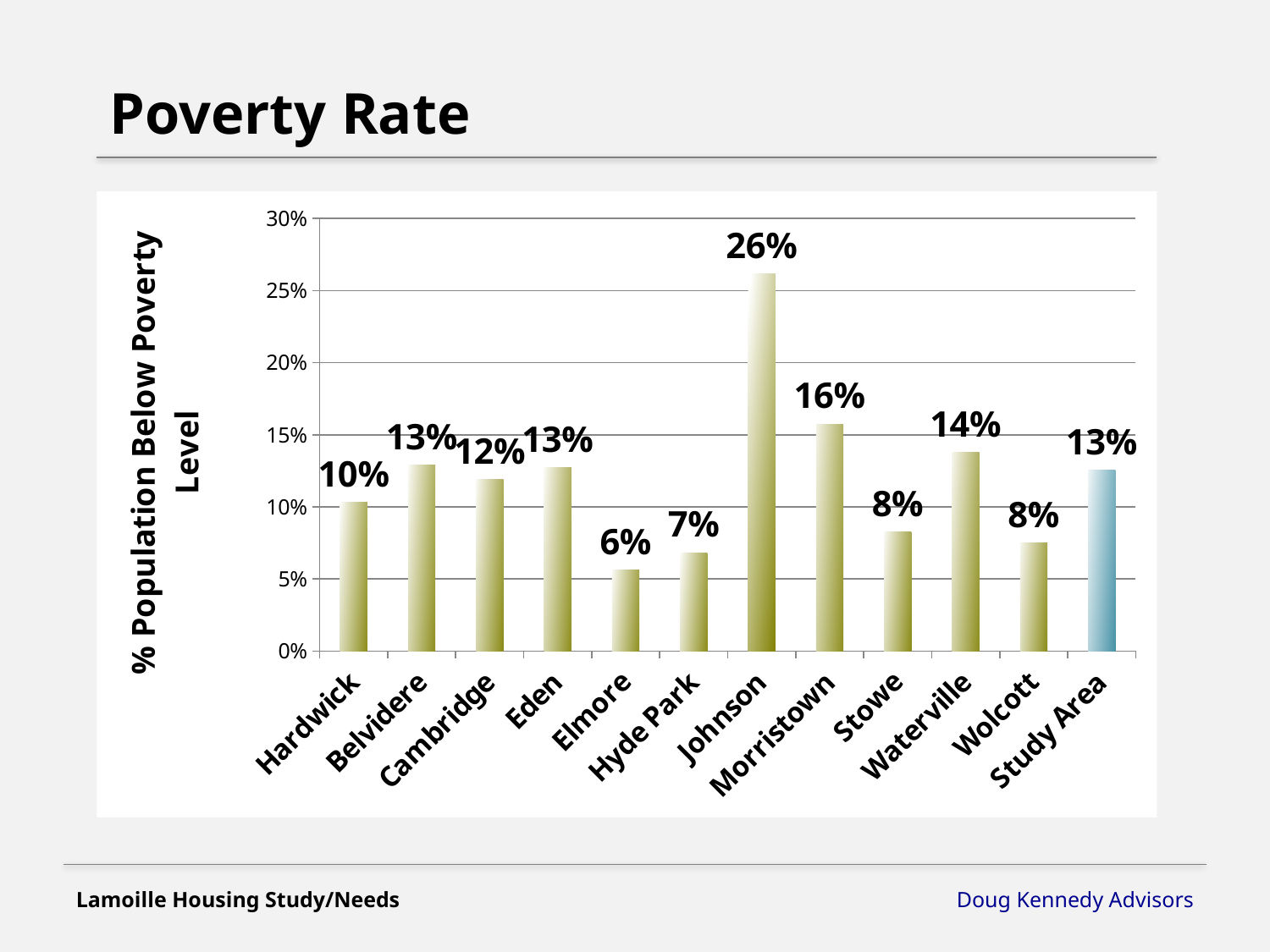
Is the value for Hardwick greater or less than 15%? less By how many percentage points does Johnson's poverty rate exceed Morristown's? 10 percentage points What kind of chart is shown on the slide? Bar chart What is the poverty rate shown for the Study Area? 13% Which has the higher poverty rate, Waterville or Cambridge? Waterville Which town has the lowest poverty rate on the chart? Elmore Which town has the highest poverty rate on the chart? Johnson How many categories are plotted on the x axis? 12 What is the title of the vertical axis? % Population Below Poverty Level What is the poverty rate shown for Johnson? 26% What is the poverty rate shown for Elmore? 6% What is the poverty rate shown for Morristown? 16%